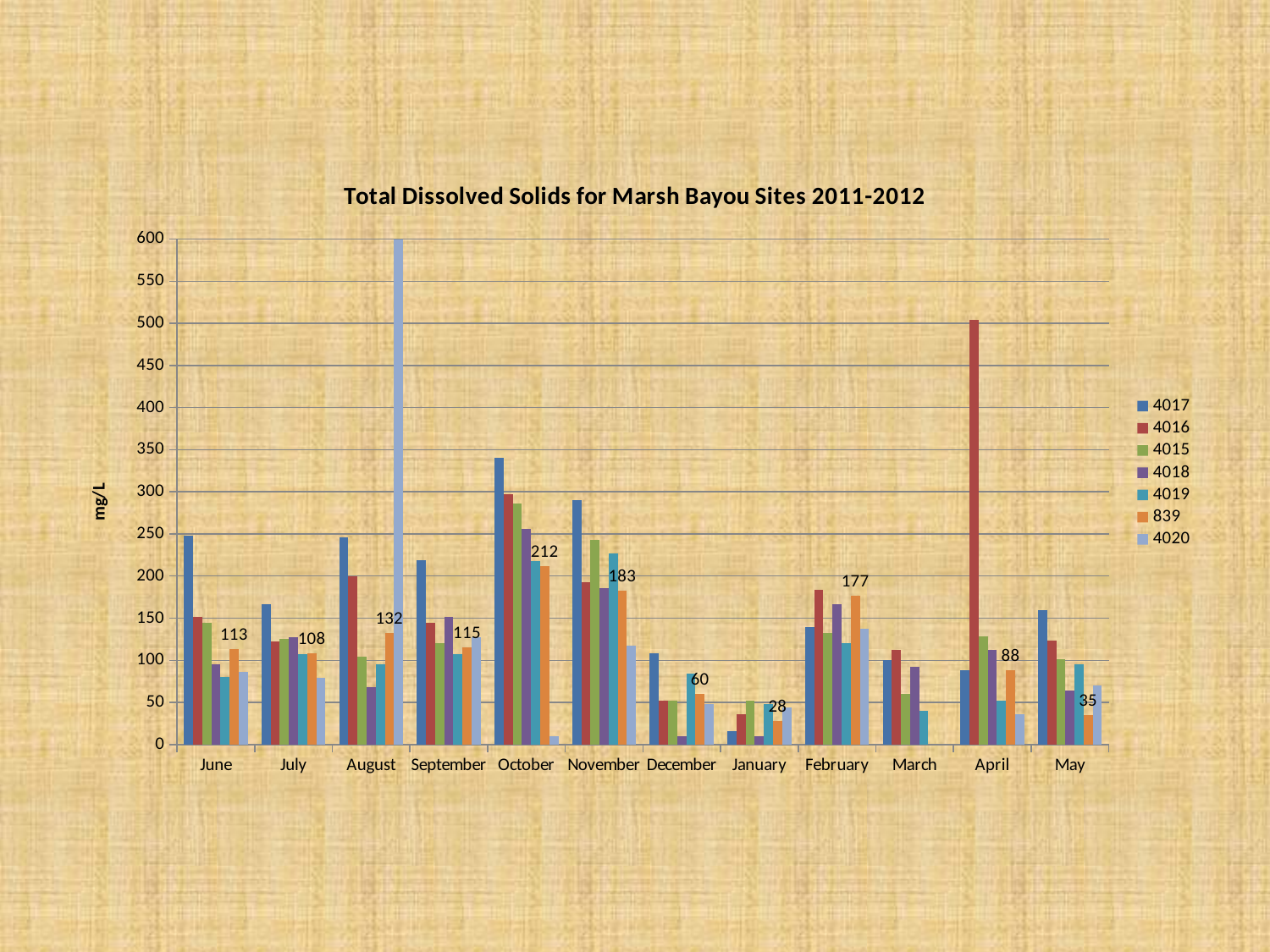
In which month is the labelled value for site 839 lowest? January How many months are shown along the x axis? 12 Which is larger for site 839: the June value or the July value? June What is the value for site 839 in February? 177 What is the value for site 839 in October? 212 Is the value for site 4016 in April greater or less than 450? greater In which month is the labelled value for site 839 highest? October How many series does the legend list? 7 What is the value for site 839 in January? 28 What is the label on the vertical axis? mg/L What kind of chart is shown on the slide? bar chart What is the difference between the site 839 values for October and November? 29